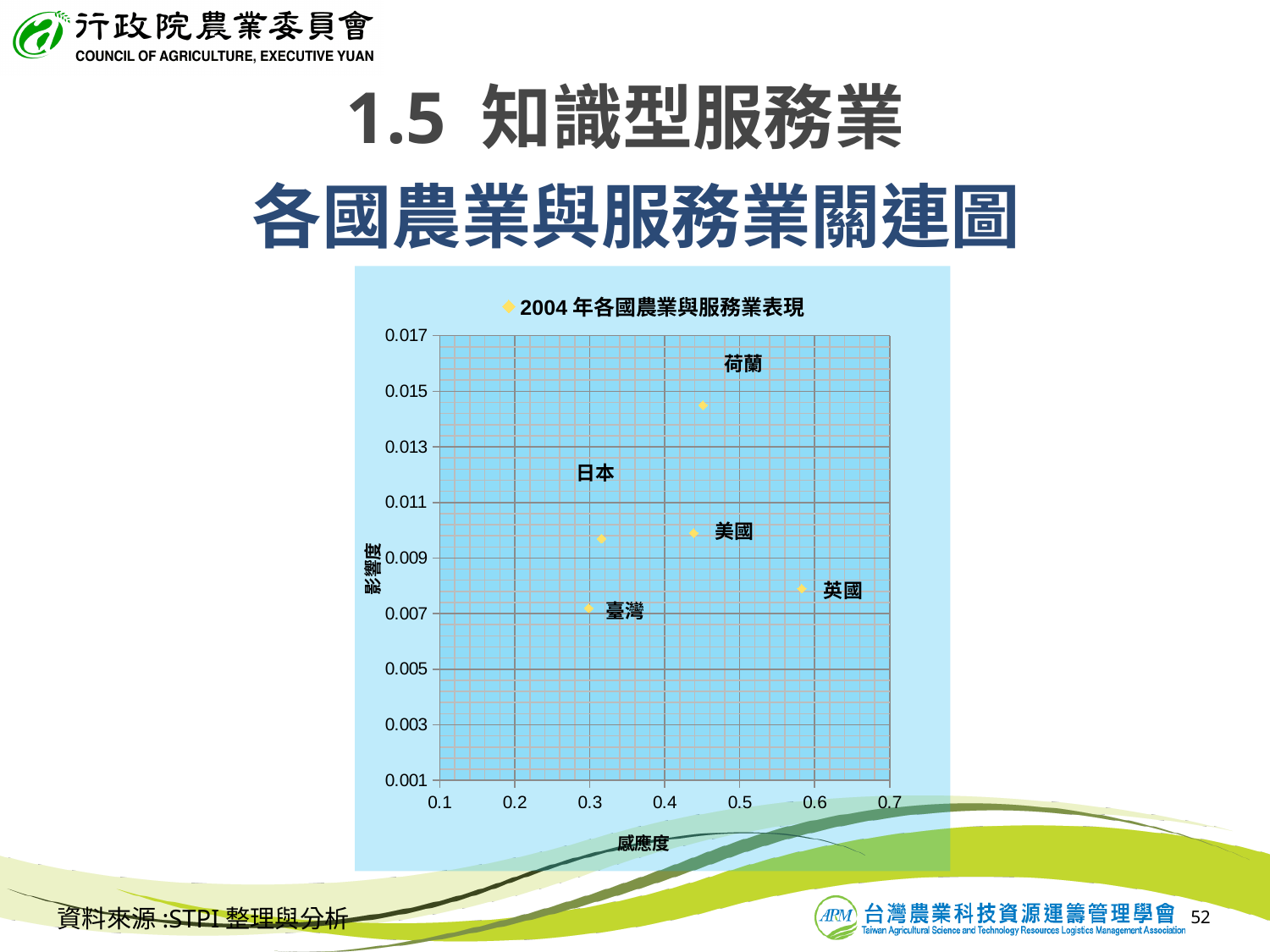
Which country has the lowest 影響度 (y-axis value) on the chart? 臺灣 What kind of chart is shown on the slide? scatter chart Which has the higher 影響度 value, 荷蘭 or 美國? 荷蘭 Is the 影響度 value for 荷蘭 greater or less than 0.013? greater Which country has the highest 感應度 (x-axis value) on the chart? 英國 Is the 影響度 value for 臺灣 greater or less than 0.009? less Is the 感應度 value for 英國 greater or less than 0.5? greater How many series does the chart legend list? 1 What is the legend entry shown above the chart? 2004 年各國農業與服務業表現 Which country has the highest 影響度 (y-axis value) on the chart? 荷蘭 How many countries are plotted as points on the chart? 5